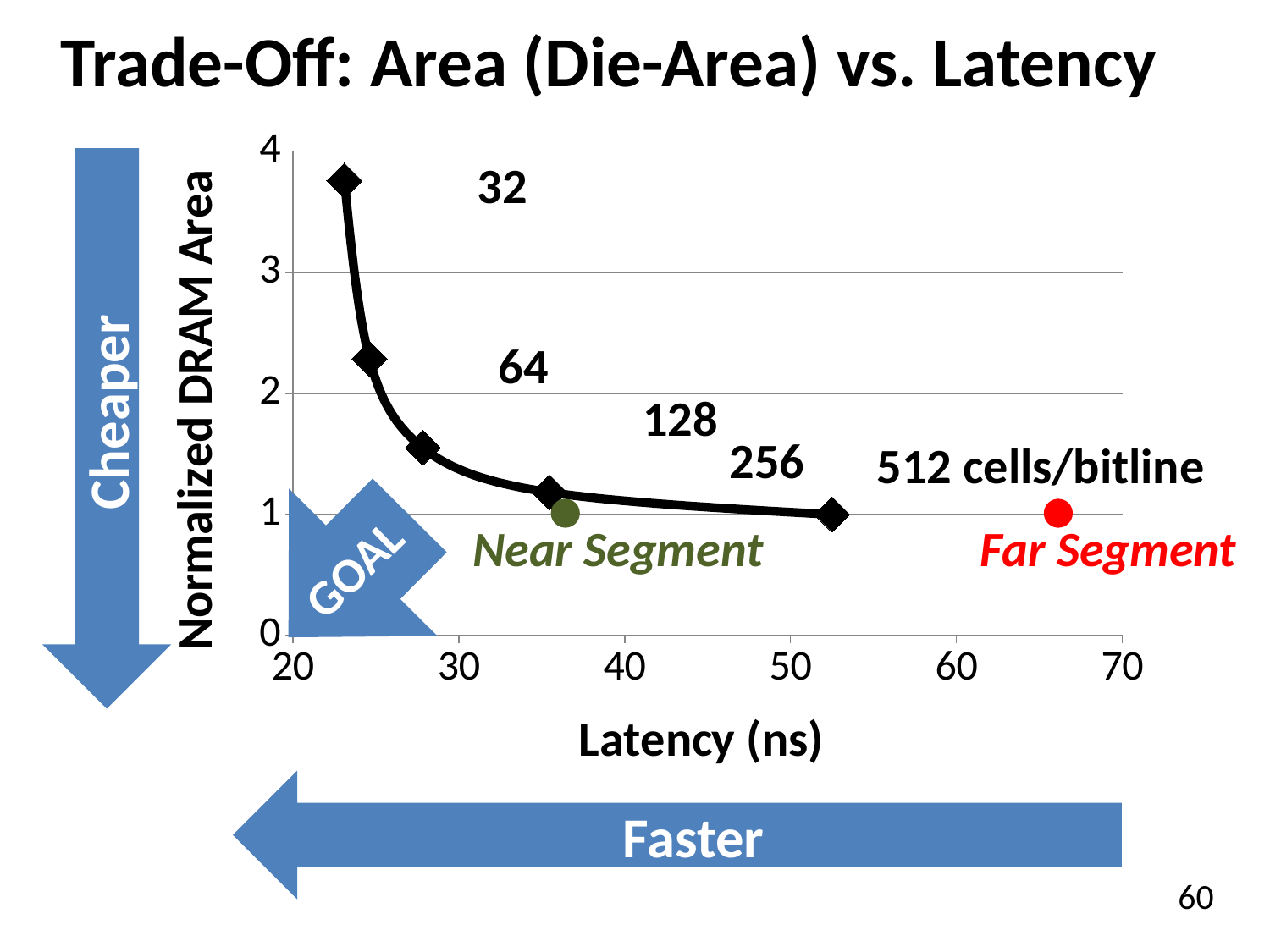
As latency increases along the x axis, does the normalized DRAM area rise or fall? fall Is the normalized DRAM area for 128 cells/bitline greater or less than 2? less Which cells/bitline configuration has the lowest normalized DRAM area? 512 Is the normalized DRAM area for 32 cells/bitline greater or less than 3? greater Which has the higher latency, the Near Segment or the Far Segment? Far Segment What is the title of the chart on the slide? Trade-Off: Area (Die-Area) vs. Latency Is the latency for 512 cells/bitline greater or less than 50 ns? greater Which has the higher normalized DRAM area, 32 cells/bitline or 64 cells/bitline? 32 cells/bitline How many cells/bitline data points (black diamonds) are plotted on the curve? 5 Which cells/bitline configuration has the highest normalized DRAM area? 32 What is the label of the x axis? Latency (ns)